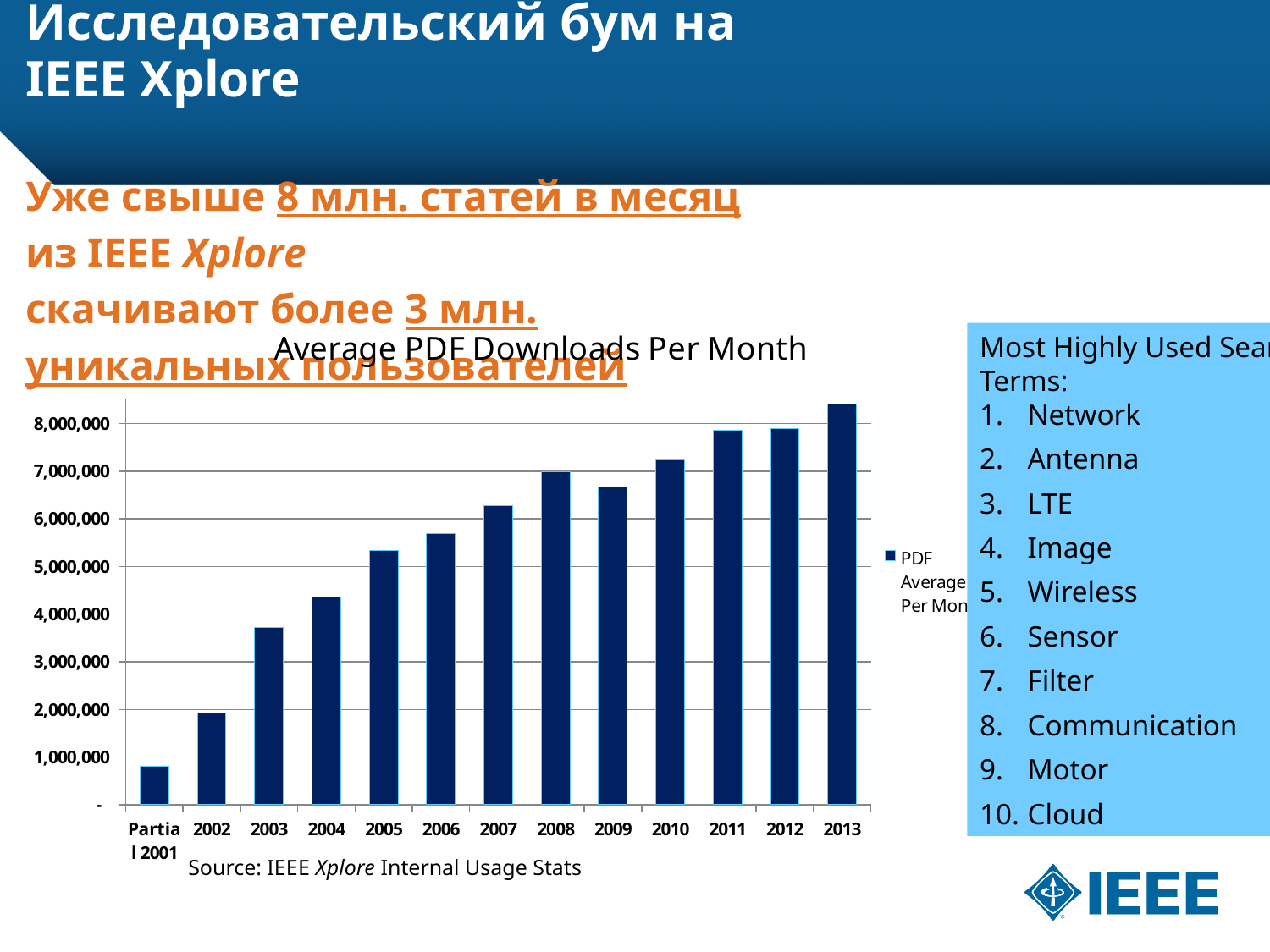
Which year has the larger value, 2003 or 2004? 2004 Which category has the lowest average PDF downloads per month? Partial 2001 What is the title of the chart? Average PDF Downloads Per Month Is the value for 2013 greater or less than 8,000,000? greater Do the values generally rise or fall from Partial 2001 to 2013? rise Which year has the highest average PDF downloads per month? 2013 Is the value for 2009 greater or less than 7,000,000? less How many categories (years) are shown on the x axis of the chart? 13 Is the value for 2005 greater or less than 5,000,000? greater What kind of chart is shown on the slide? bar chart Which year has the larger value, 2008 or 2009? 2008